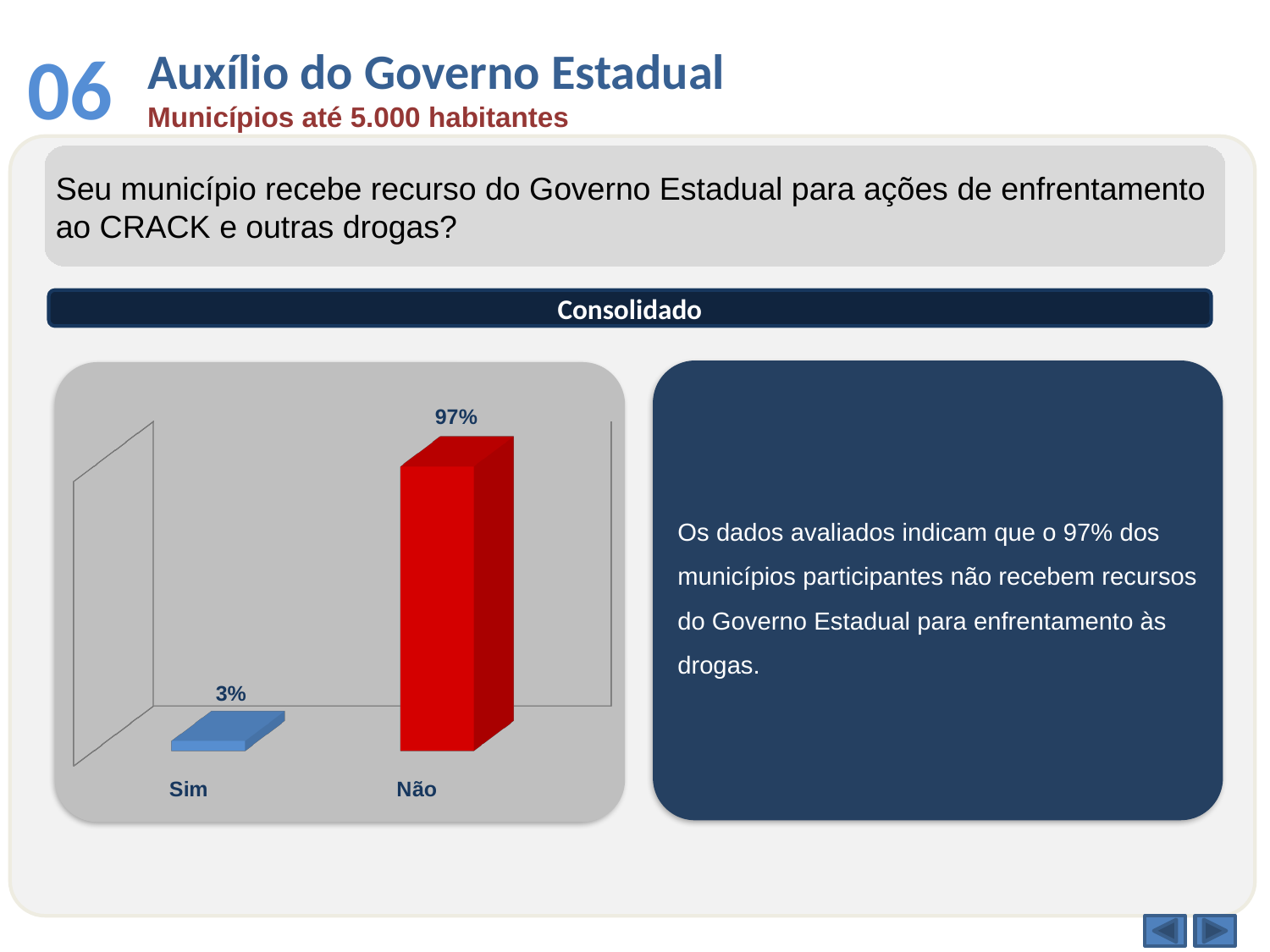
What is the value for "Sim" in the chart? 3% What is the total of the two values shown in the chart? 100% Which is larger, the value for "Sim" or the value for "Não"? Não What is the value for "Não" in the chart? 97% How many categories are shown in the chart? 2 What colour is the bar for "Não"? Red Which category has the lowest value in the chart? Sim What kind of chart is shown on the slide? Bar chart What colour is the bar for "Sim"? Blue What is the difference between the values for "Não" and "Sim"? 94% Which category has the highest value in the chart? Não